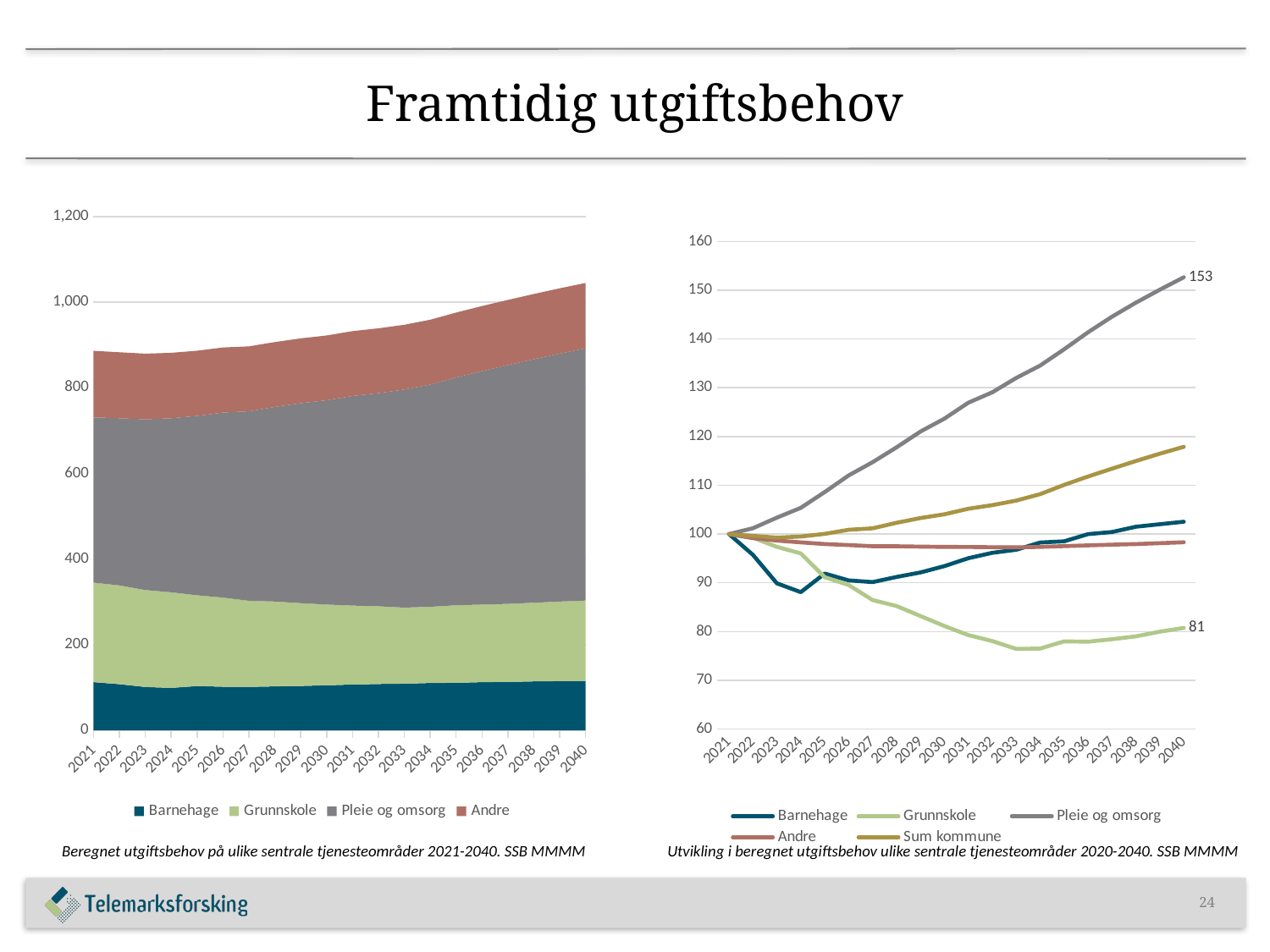
In the right chart, what is the value for Grunnskole in 2040? 81 How many years are shown on the x axis of the left chart? 20 In the right chart, what is the value for Pleie og omsorg in 2040? 153 In the right chart, is the value for Sum kommune in 2040 greater or less than 110? greater What kind of chart is the right chart on the slide? line chart In the right chart, which series has the lowest value in 2040? Grunnskole In the left chart, is the total stacked value in 2040 greater or less than 1,000? greater In the right chart, what is the difference between the 2040 values for Pleie og omsorg and Grunnskole? 72 How many series does the legend of the right chart list? 5 How many series does the legend of the left chart list? 4 What kind of chart is the left chart on the slide? stacked area chart In the right chart, which series has the highest value in 2040? Pleie og omsorg